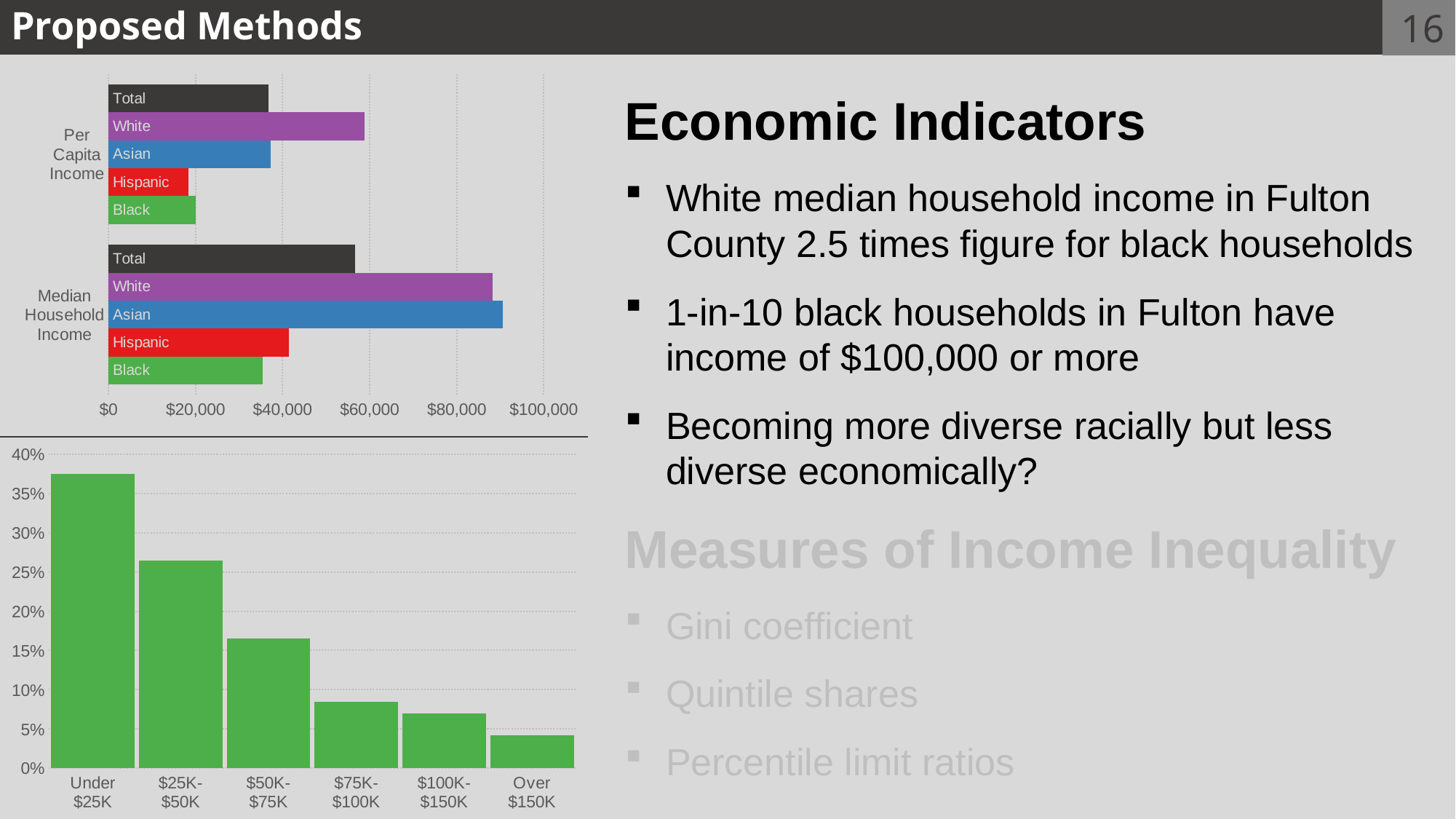
In the top chart, how many groups are shown within each income category? 5 In the top chart, is the Per Capita Income for Hispanic greater or less than $40,000? less In the bottom chart, how many income brackets are shown on the x axis? 6 In the bottom chart, do the values rise or fall as you move from Under $25K to Over $150K? fall In the top chart, which group has the highest Per Capita Income? White In the bottom chart, which income bracket has the highest value? Under $25K What kind of chart is the top chart on the slide (Per Capita Income / Median Household Income)? bar chart In the top chart, is the Per Capita Income for White greater or less than $40,000? greater In the bottom chart, which income bracket has the lowest value? Over $150K In the top chart, is the Median Household Income for Black greater or less than $40,000? less What kind of chart is the bottom chart on the slide (income brackets from Under $25K to Over $150K)? bar chart In the top chart, which is larger for Median Household Income: White or Hispanic? White